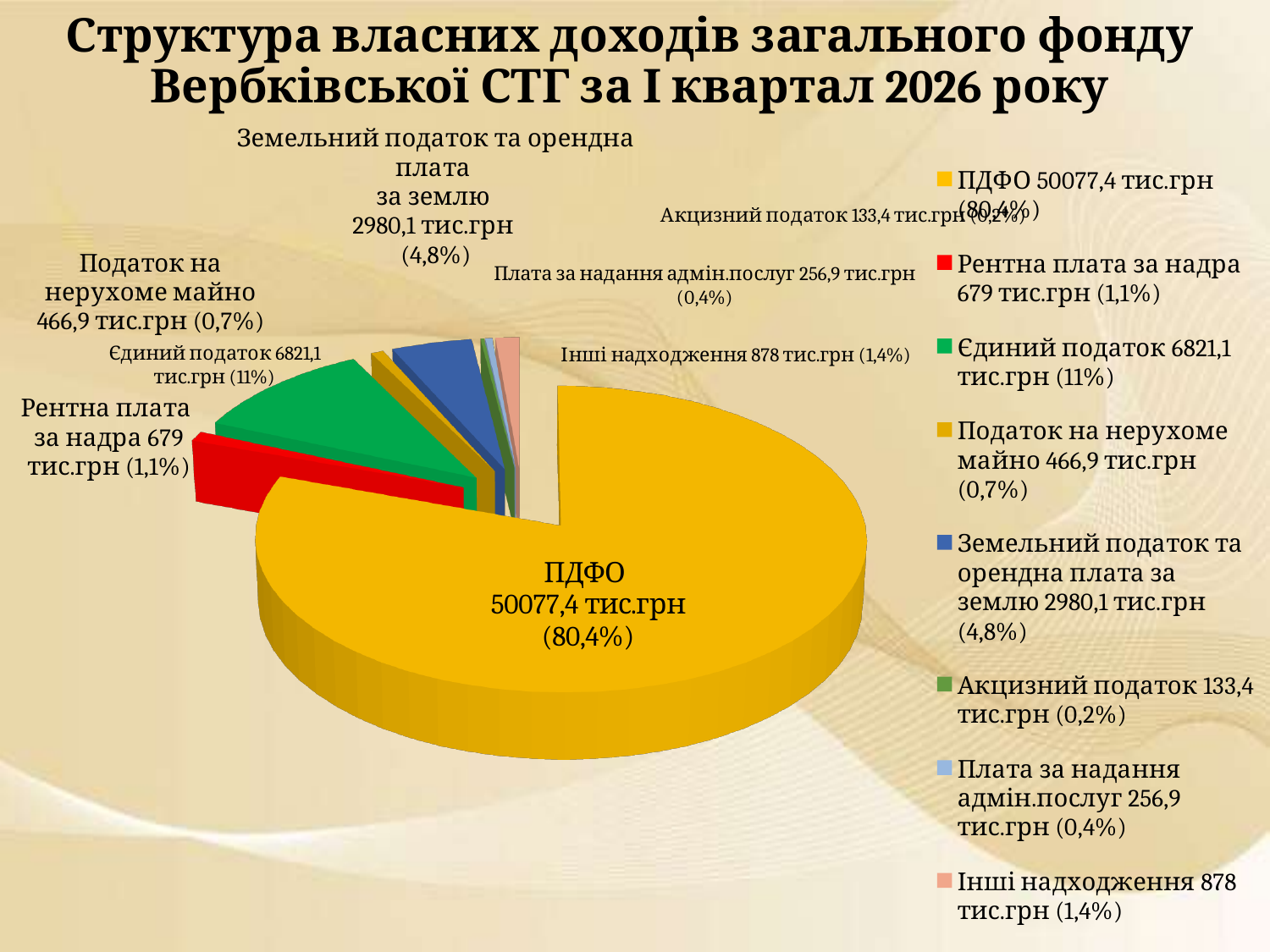
Which category has the largest slice of the pie? ПДФО What is the value for Плата за надання адмін.послуг? 256,9 тис.грн What is the value for Єдиний податок? 6821,1 тис.грн What period does the chart title say the data covers? І квартал 2026 року What share of the pie does Рентна плата за надра represent? 1,1% What kind of chart is shown on the slide? pie chart Which category has the smallest slice of the pie? Акцизний податок How many categories does the pie chart show? 8 What is the value for ПДФО? 50077,4 тис.грн What is the difference between Інші надходження (878 тис.грн) and Рентна плата за надра (679 тис.грн)? 199 тис.грн What share of the pie does Земельний податок та орендна плата за землю represent? 4,8% Which is larger: Інші надходження or Податок на нерухоме майно? Інші надходження